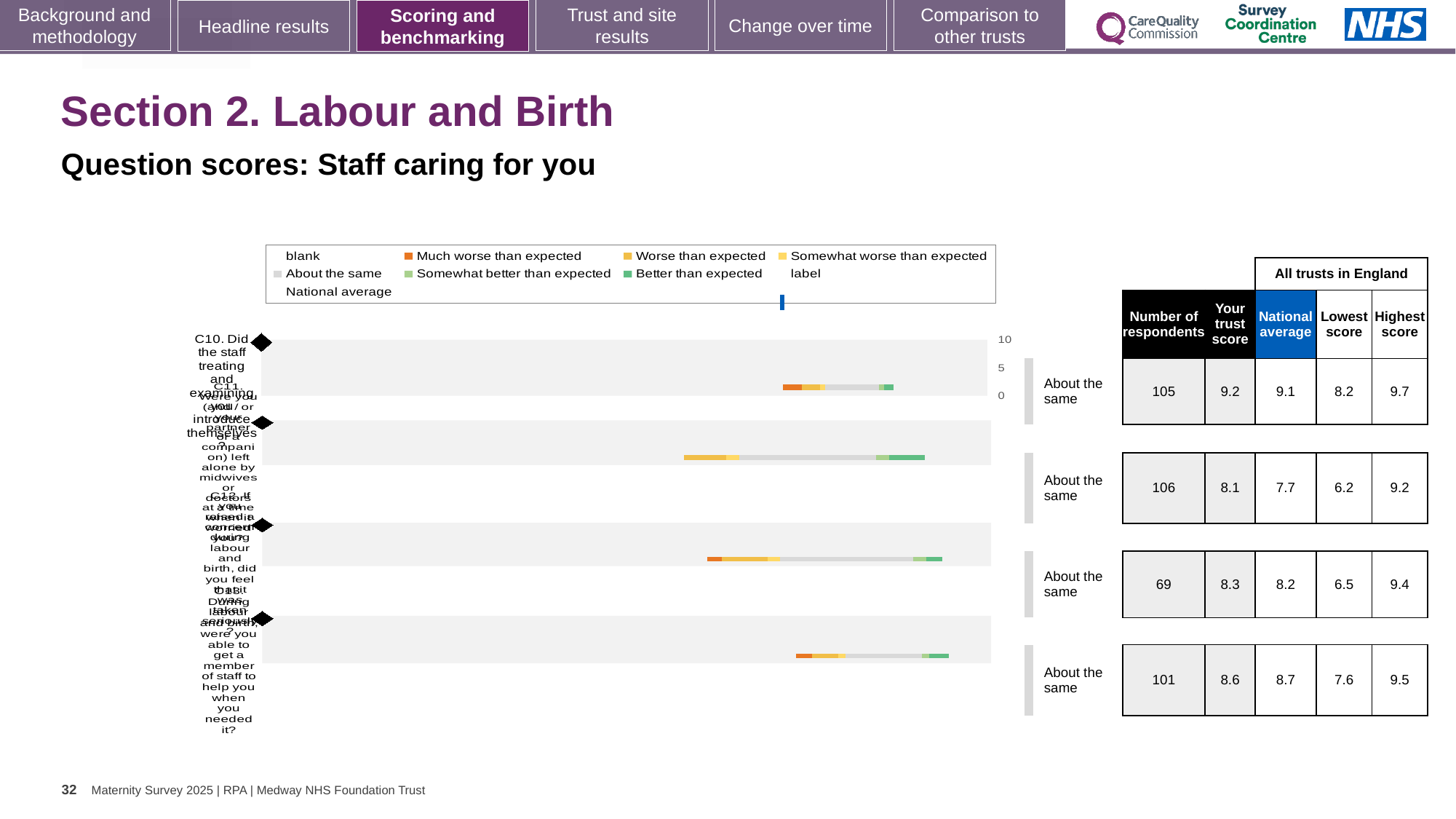
In the table next to the chart, what is the national average for the fourth row (C13)? 8.7 Which row has the lowest number of respondents in the table? third row (C12), 69 Which row has the highest number of respondents in the table? second row (C11), 106 In the table next to the chart, what is the trust score for the second row (C11)? 8.1 Which is larger: the trust score for the first row (C10) or the trust score for the fourth row (C13)? first row (C10), 9.2 In the table next to the chart, what is the number of respondents for the first row (C10)? 105 What benchmark rating is shown for every row of the chart? About the same How many question rows (bars) does the chart show? 4 What colour does the legend use for 'Much worse than expected'? orange In the table next to the chart, what is the lowest score for the third row (C12)? 6.5 What is the difference in number of respondents between the second row (106) and the third row (69)? 37 What kind of chart is shown on the slide? bar chart